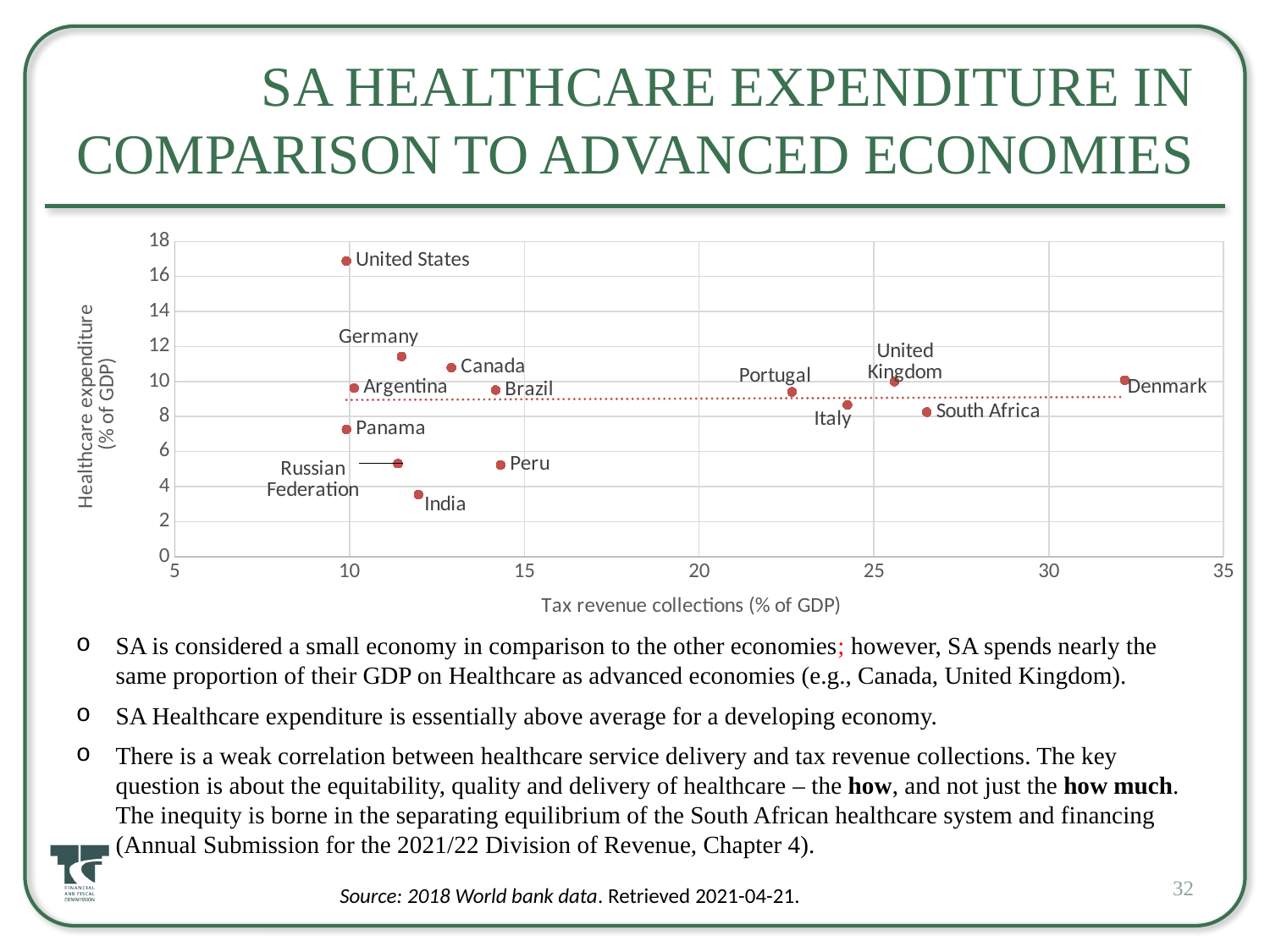
How many countries are plotted on the chart? 14 What kind of chart is shown on the slide? Scatter chart Is the healthcare expenditure value for the United States greater or less than 16? greater Which country has the lowest healthcare expenditure (% of GDP) on the chart? India Which country has the highest healthcare expenditure (% of GDP) on the chart? United States Is the healthcare expenditure value for India greater or less than 4? less What is the title of the horizontal axis of the chart? Tax revenue collections (% of GDP) Which country has the highest tax revenue collections (% of GDP) on the chart? Denmark Is the tax revenue collections value for Denmark greater or less than 30? greater Which has the higher tax revenue collections (% of GDP), Denmark or Italy? Denmark Which has the higher healthcare expenditure (% of GDP), Canada or South Africa? Canada